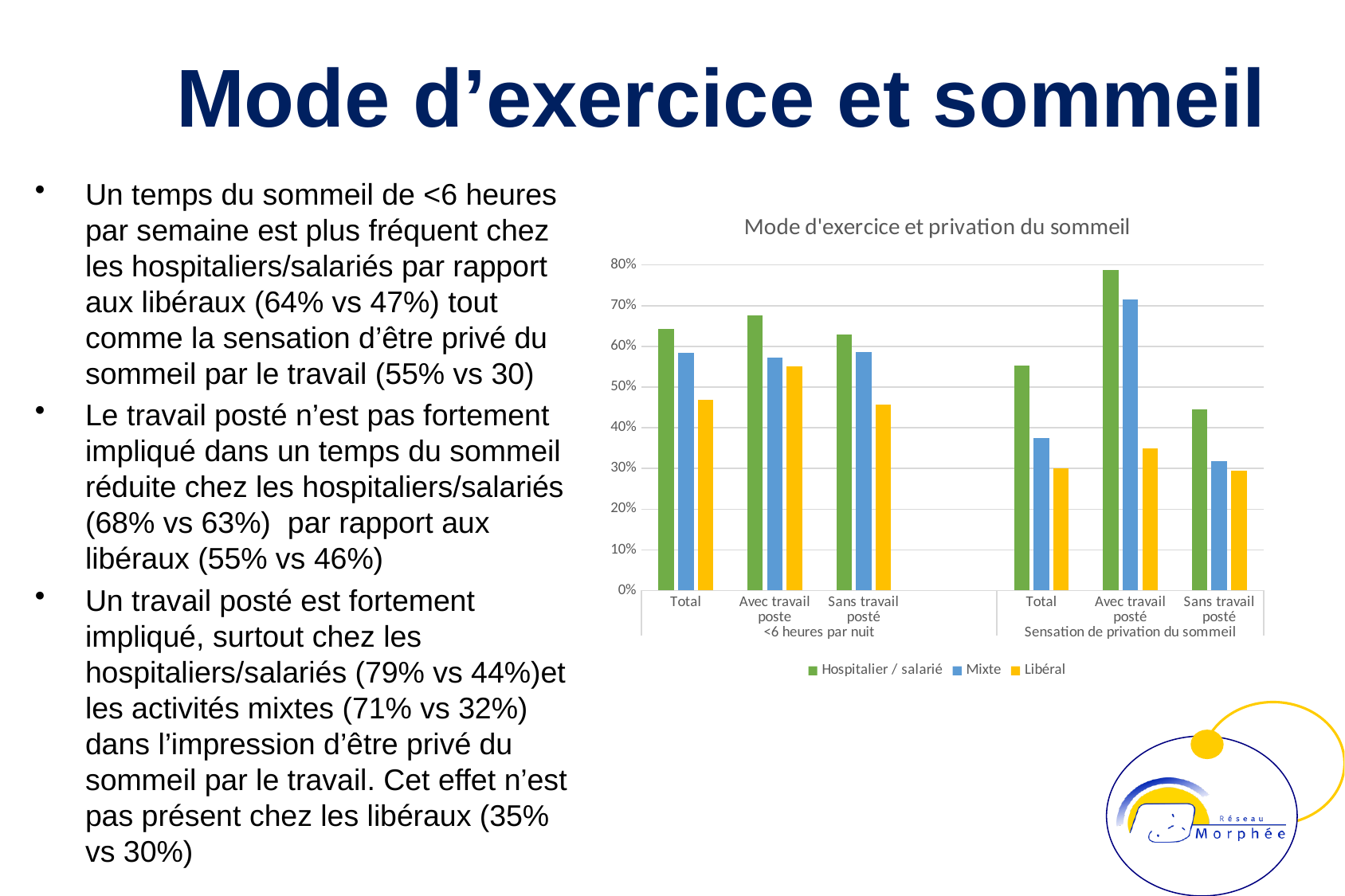
How many series does the chart legend list? 3 Is the Hospitalier / salarié value for Total under '<6 heures par nuit' greater or less than 60%? greater Is the Libéral value for Total under '<6 heures par nuit' greater or less than 50%? less Which series has the tallest bar in the chart overall? Hospitalier / salarié How many category groups are plotted along the x axis of the chart? 6 In which category group does the Hospitalier / salarié series reach its highest value? Avec travail posté (Sensation de privation du sommeil) Is the Hospitalier / salarié value for Avec travail posté under 'Sensation de privation du sommeil' greater or less than 70%? greater What is the title of the chart? Mode d'exercice et privation du sommeil For Total under 'Sensation de privation du sommeil', which is larger: the Hospitalier / salarié value or the Mixte value? Hospitalier / salarié What kind of chart is shown on the slide? bar chart Which series is shown in green in the chart? Hospitalier / salarié